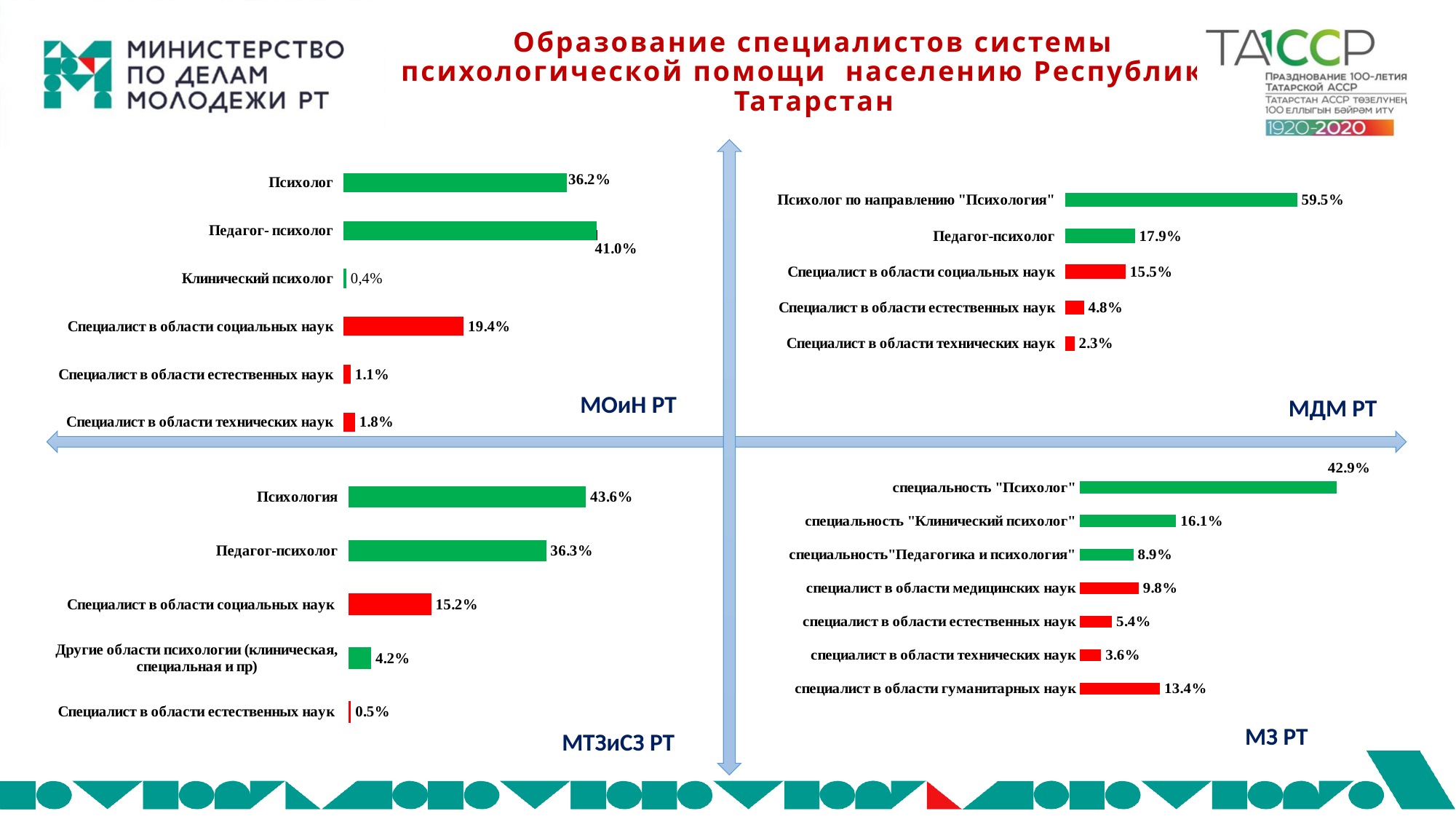
In the МДМ РТ chart (top right), which category has the lowest value? Специалист в области технических наук In the МТЗиСЗ РТ chart (bottom left), which category has the highest value? Психология In the МОиН РТ chart (top left), how many categories are shown? 6 In the МОиН РТ chart (top left), what is the value for Педагог-психолог? 41.0% In the МОиН РТ chart (top left), which category has the lowest value? Клинический психолог In the МТЗиСЗ РТ chart (bottom left), what is the value for Специалист в области социальных наук? 15.2% In the МЗ РТ chart (bottom right), which is larger: специальность "Клинический психолог" or специалист в области медицинских наук? специальность "Клинический психолог" In the МЗ РТ chart (bottom right), what is the value for специалист в области гуманитарных наук? 13.4% In the МДМ РТ chart (top right), what is the value for Психолог по направлению "Психология"? 59.5% What type of chart is the МЗ РТ chart (bottom right)? Bar chart In the МЗ РТ chart (bottom right), how many categories are shown? 7 In the МДМ РТ chart (top right), what is the difference between Психолог по направлению "Психология" and Педагог-психолог? 41.6%